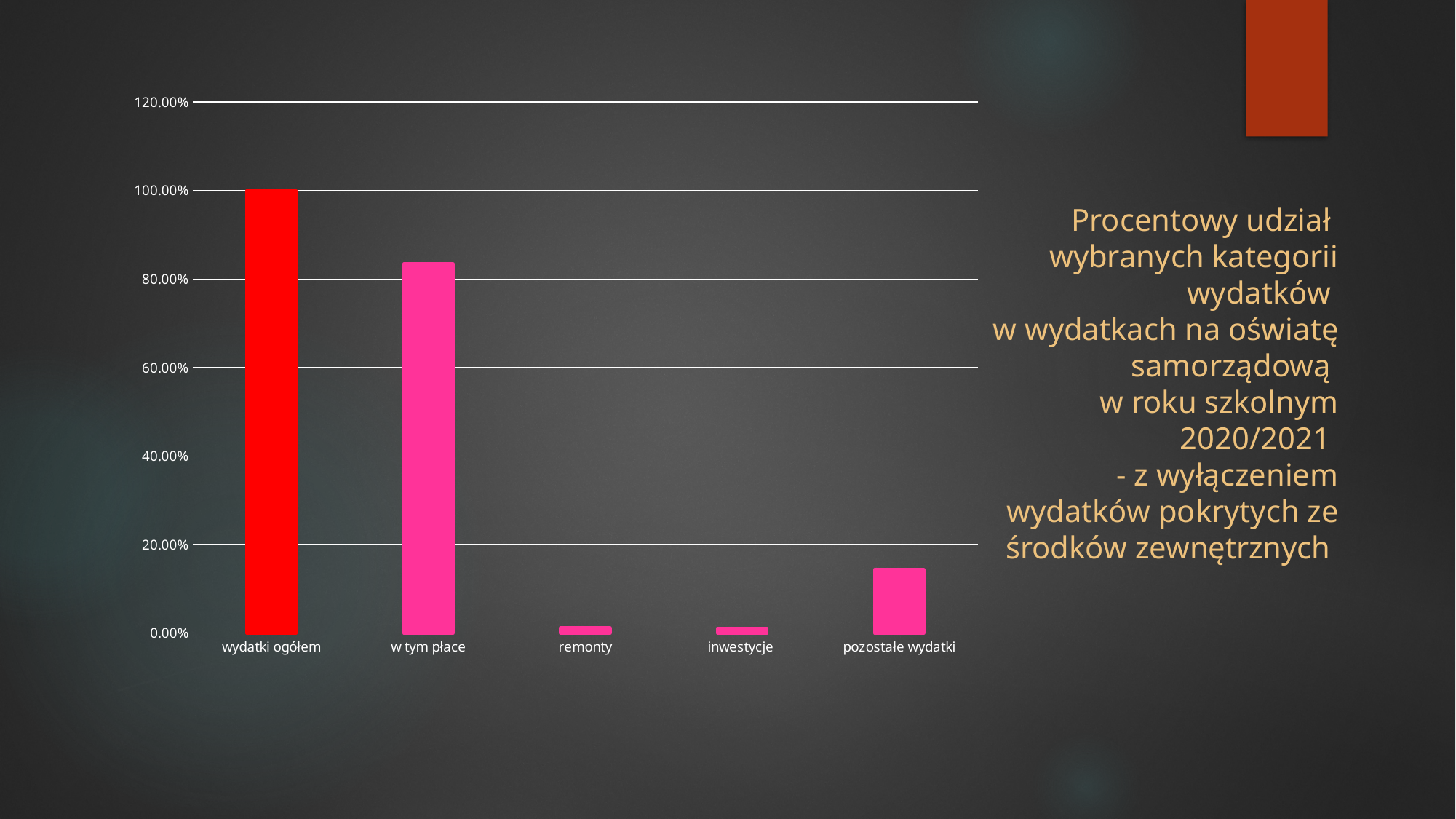
Is the value for "pozostałe wydatki" greater or less than 20.00%? less What kind of chart is shown on the slide? bar chart What is the value for "wydatki ogółem"? 100.00% Which is larger, the value for "pozostałe wydatki" or the value for "remonty"? pozostałe wydatki Is the value for "remonty" greater or less than 20.00%? less What colour is the bar for "wydatki ogółem"? red How many categories are plotted on the chart? 5 Which category has the highest value? wydatki ogółem Is the value for "inwestycje" greater or less than 20.00%? less What is the highest value shown on the vertical axis? 120.00% Which is larger, the value for "w tym płace" or the value for "pozostałe wydatki"? w tym płace